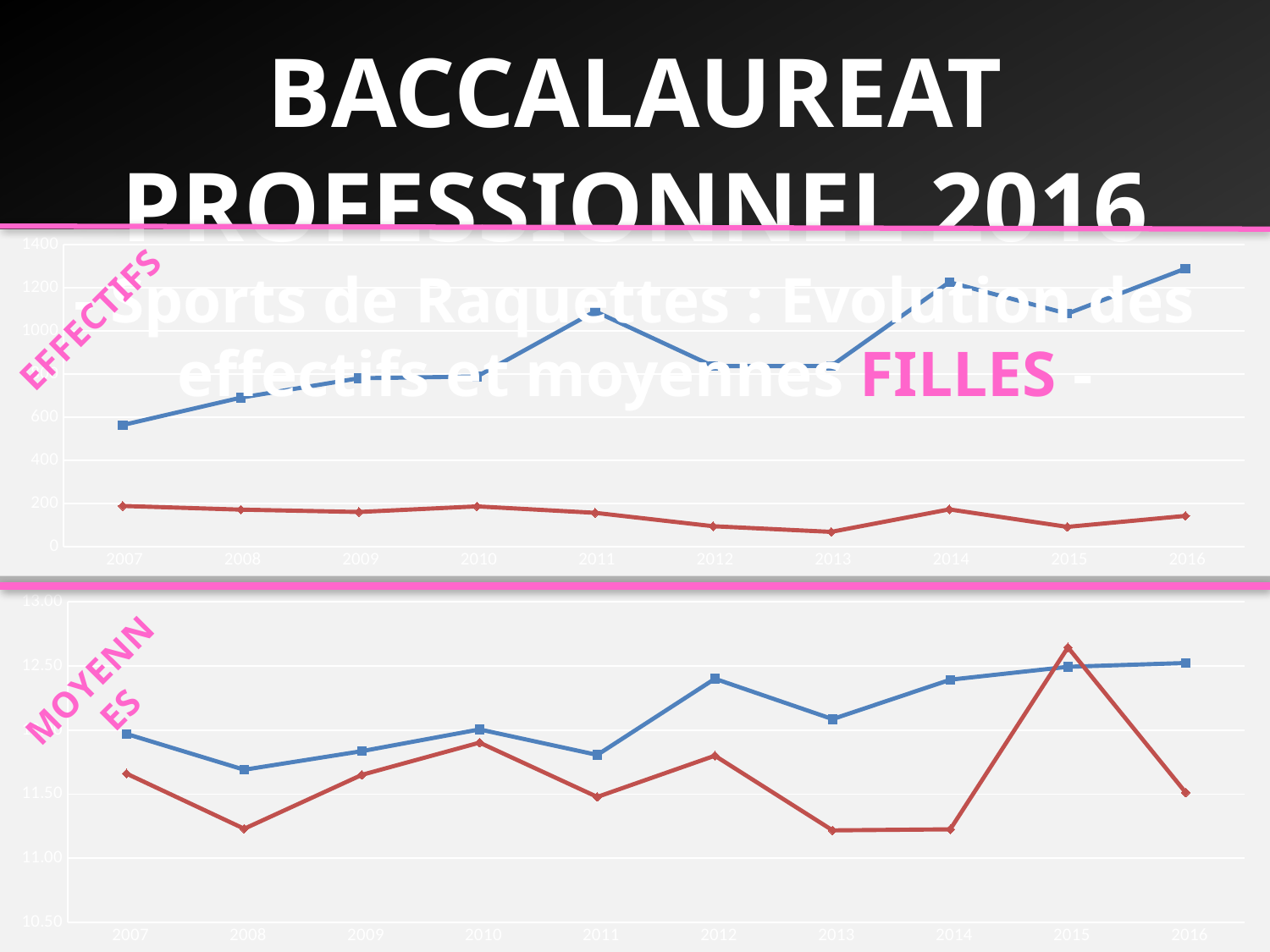
What type of chart is the top chart labelled EFFECTIFS? Line chart In the top chart (EFFECTIFS), in which year is the red line at its lowest? 2013 In the top chart (EFFECTIFS), in which year is the blue line at its lowest? 2007 In the bottom chart (MOYENNES), in which year is the red line at its highest? 2015 In the top chart (EFFECTIFS), how many years are shown on the x axis? 10 In the top chart (EFFECTIFS), is the value of the blue line for 2016 greater or less than 1200? greater In the top chart (EFFECTIFS), how many lines are plotted? 2 In the bottom chart (MOYENNES), is the value of the red line for 2015 greater or less than 12.50? greater In the top chart (EFFECTIFS), does the blue line overall rise or fall from 2007 to 2016? Rise In the bottom chart (MOYENNES), in which year is the blue line at its lowest? 2008 In the bottom chart (MOYENNES), which line has the larger value in 2013, the blue line or the red line? The blue line In the top chart (EFFECTIFS), is the value of the blue line for 2007 greater or less than 600? less